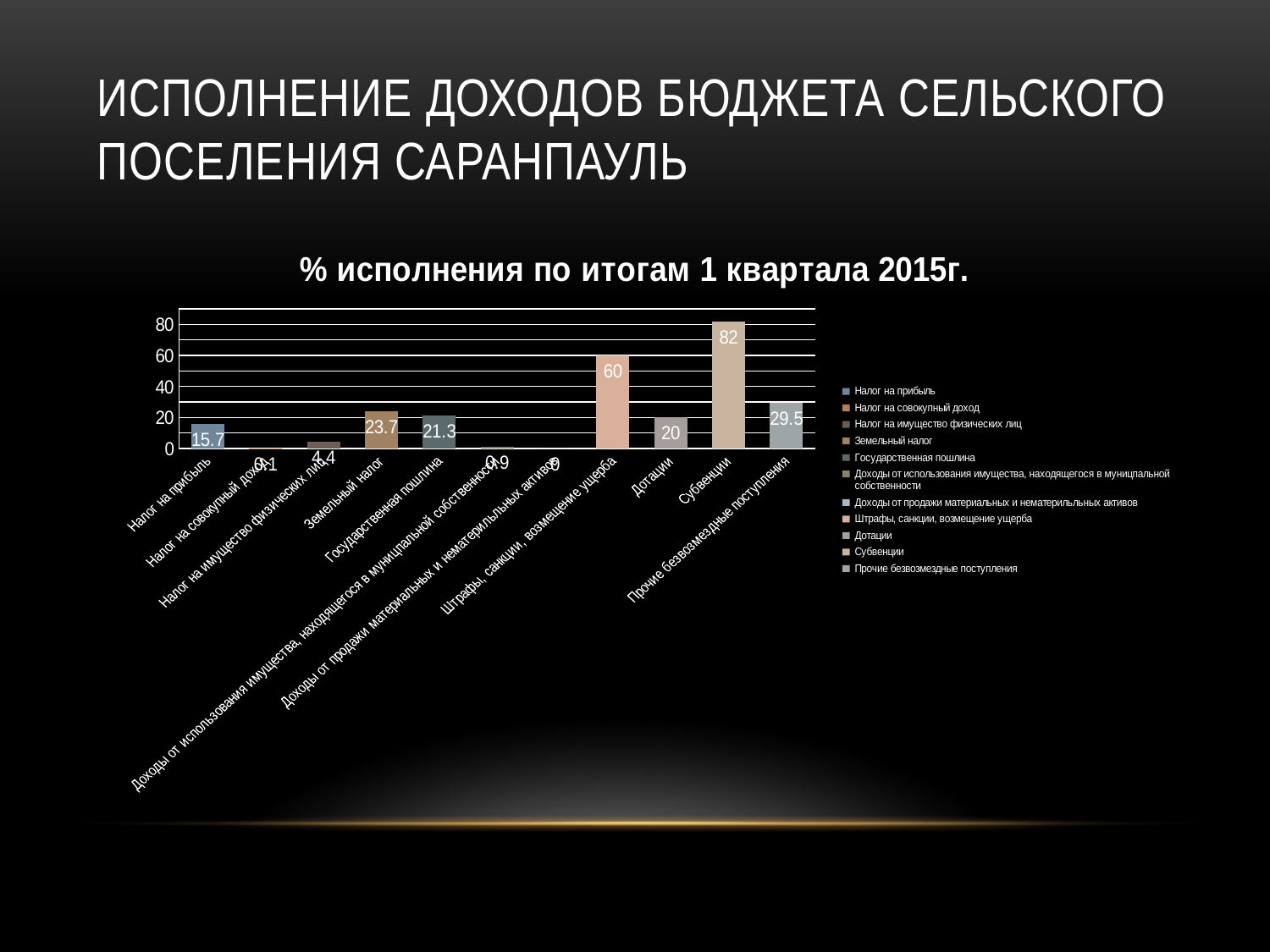
What is the value for Субвенции? 82 Is the value for Штрафы, санкции, возмещение ущерба greater or less than 40? greater What is the value for Прочие безвозмездные поступления? 29.5 What is the title of the chart? % исполнения по итогам 1 квартала 2015г. What kind of chart is shown on the slide? bar chart Which category has the highest value? Субвенции Which category has the lowest value? Доходы от продажи материальных и нематерильных активов What is the difference between the values for Субвенции and Штрафы, санкции, возмещение ущерба? 22 Which is larger, the value for Земельный налог or the value for Государственная пошлина? Земельный налог What is the value for Налог на прибыль? 15.7 What is the value for Земельный налог? 23.7 How many categories are shown on the x axis? 11